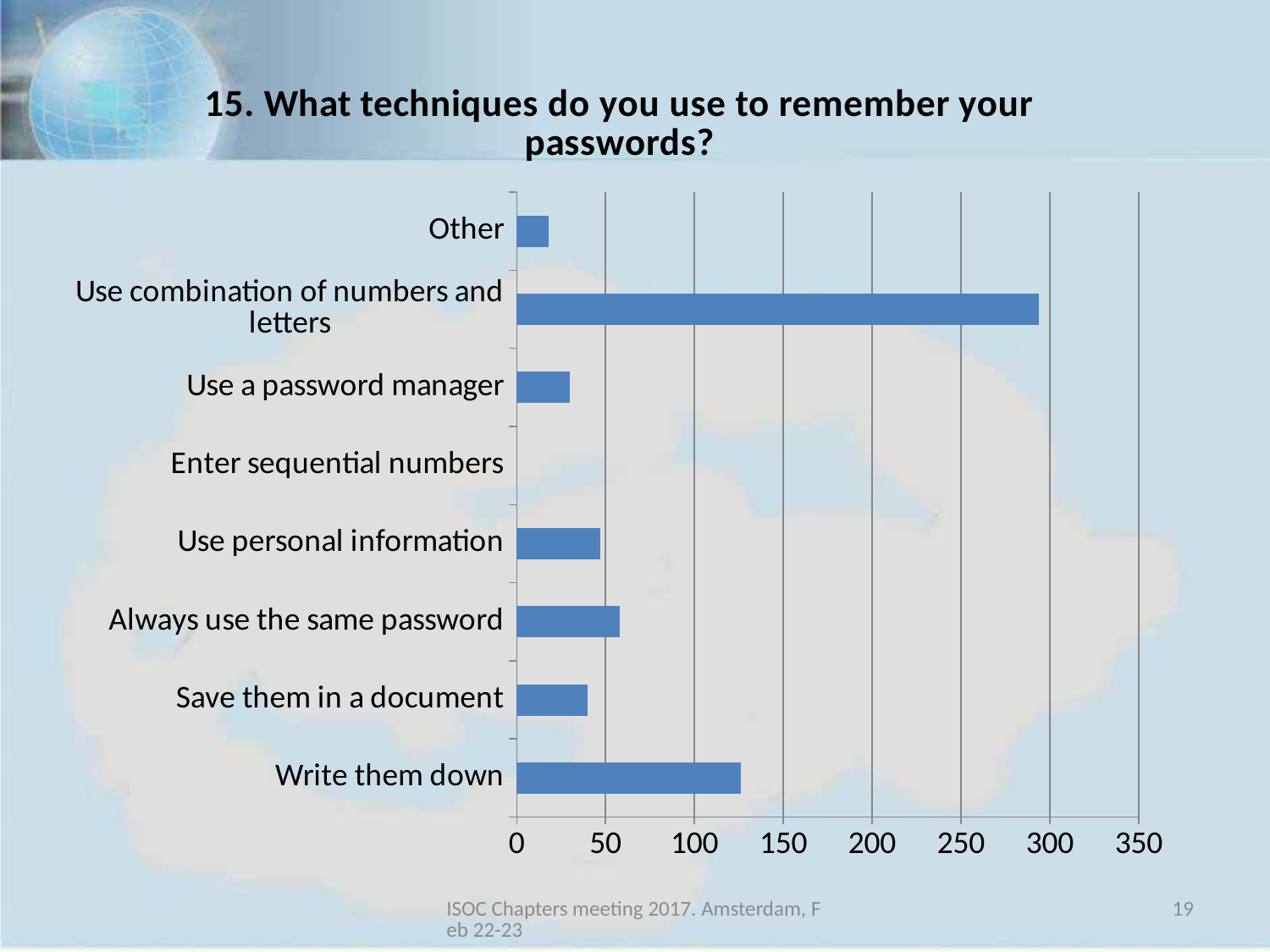
Which technique has the highest value? Use combination of numbers and letters Is the value for Other greater or less than 50? less Which technique has the lowest value? Enter sequential numbers Which is larger, the value for Write them down or the value for Use a password manager? Write them down What kind of chart is shown on the slide? bar chart Is the value for Use a password manager greater or less than 50? less Is the value for Save them in a document greater or less than 50? less How many categories are shown on the chart? 8 Which is larger, the value for Always use the same password or the value for Other? Always use the same password What is the title of the chart? 15. What techniques do you use to remember your passwords?